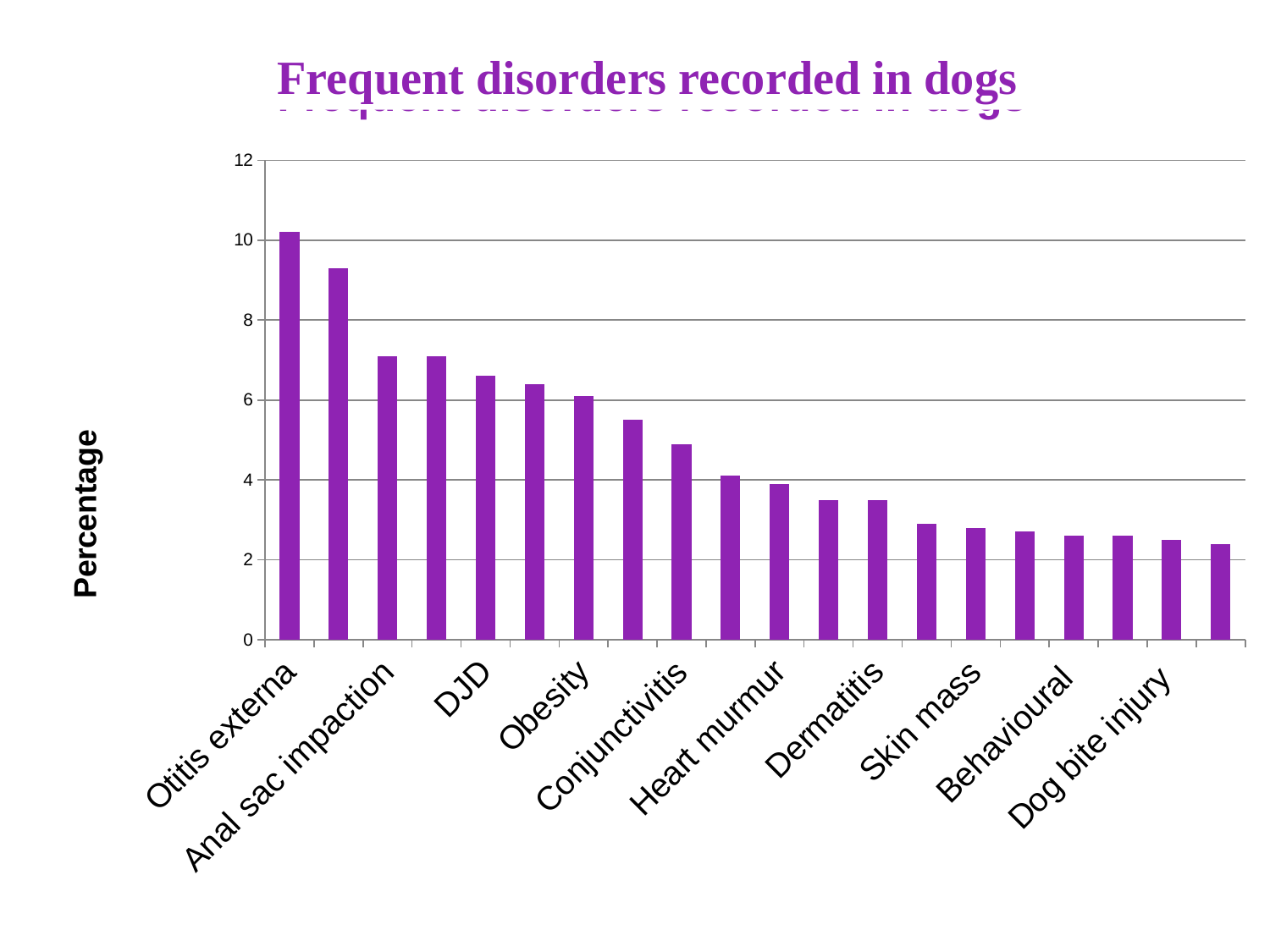
Is the value for Dog bite injury greater or less than 2? greater Is the value for Dermatitis greater or less than 4? less Is the value for Skin mass greater or less than 4? less What is the title of the chart's vertical axis? Percentage Do the bar values rise or fall from left to right across the chart? fall Which has the larger value, Otitis externa or Heart murmur? Otitis externa Which disorder has the highest percentage in the chart? Otitis externa What kind of chart is shown on the slide? bar chart